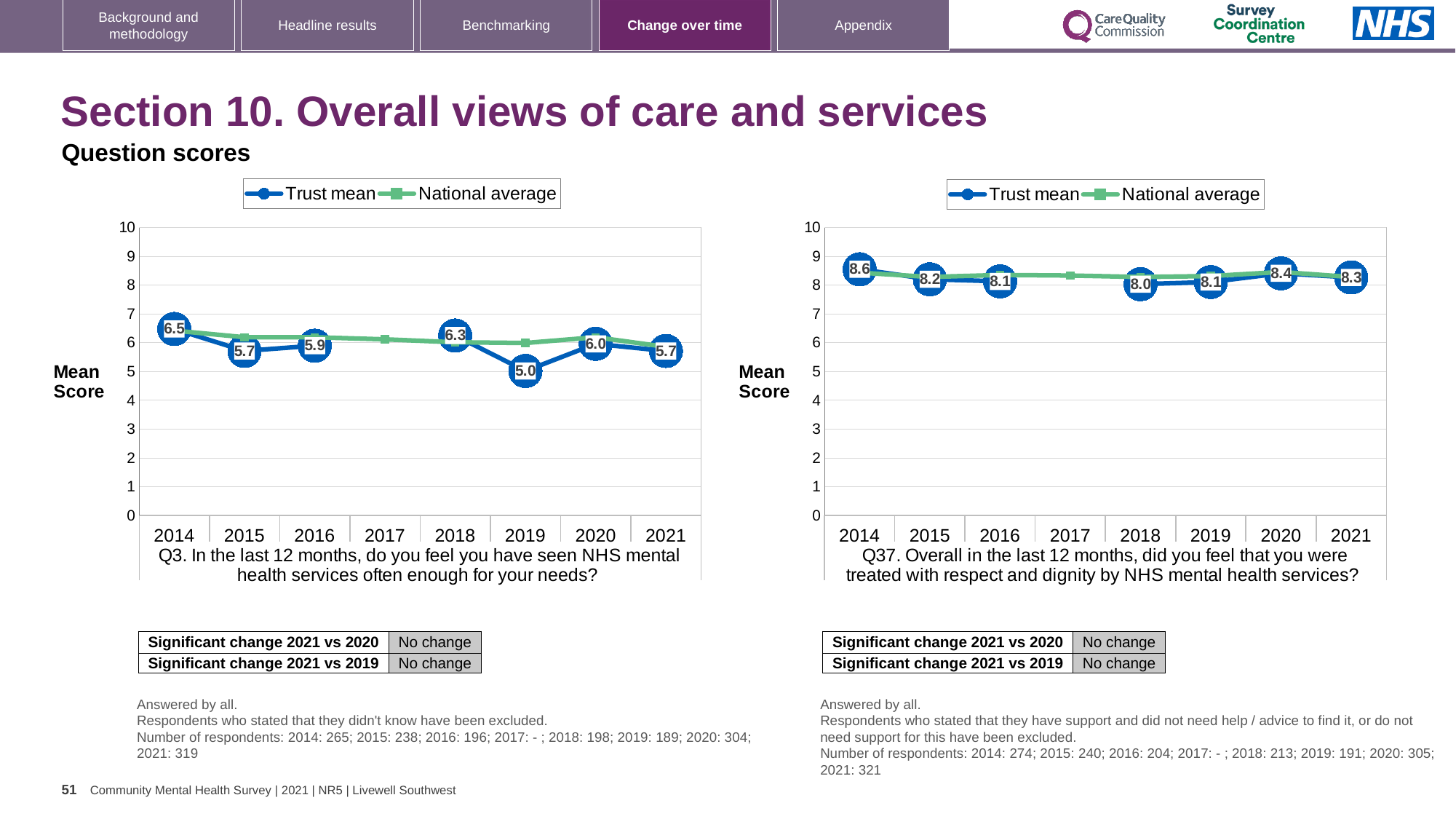
In the Q37 chart on the right, which year has the lowest Trust mean score? 2018 In the Q37 chart on the right, which is larger, the Trust mean score for 2020 or for 2016? 2020 What is the label on the y axis of the Q37 chart on the right? Mean Score In the Q3 chart on the left, which year has the highest Trust mean score? 2014 In the Q37 chart on the right, what is the Trust mean score for 2014? 8.6 In the Q3 chart on the left, does the Trust mean score rise or fall from 2014 to 2015? Fall In the Q37 chart on the right, is the National average value for 2017 greater or less than 7? greater What kind of chart is the Q3 chart on the left? Line chart How many years are shown on the x axis of the Q3 chart on the left? 8 How many series does the legend of the Q37 chart on the right list? 2 In the Q3 chart on the left, what is the Trust mean score for 2019? 5.0 In the Q3 chart on the left, what is the difference between the Trust mean scores for 2018 and 2019? 1.3